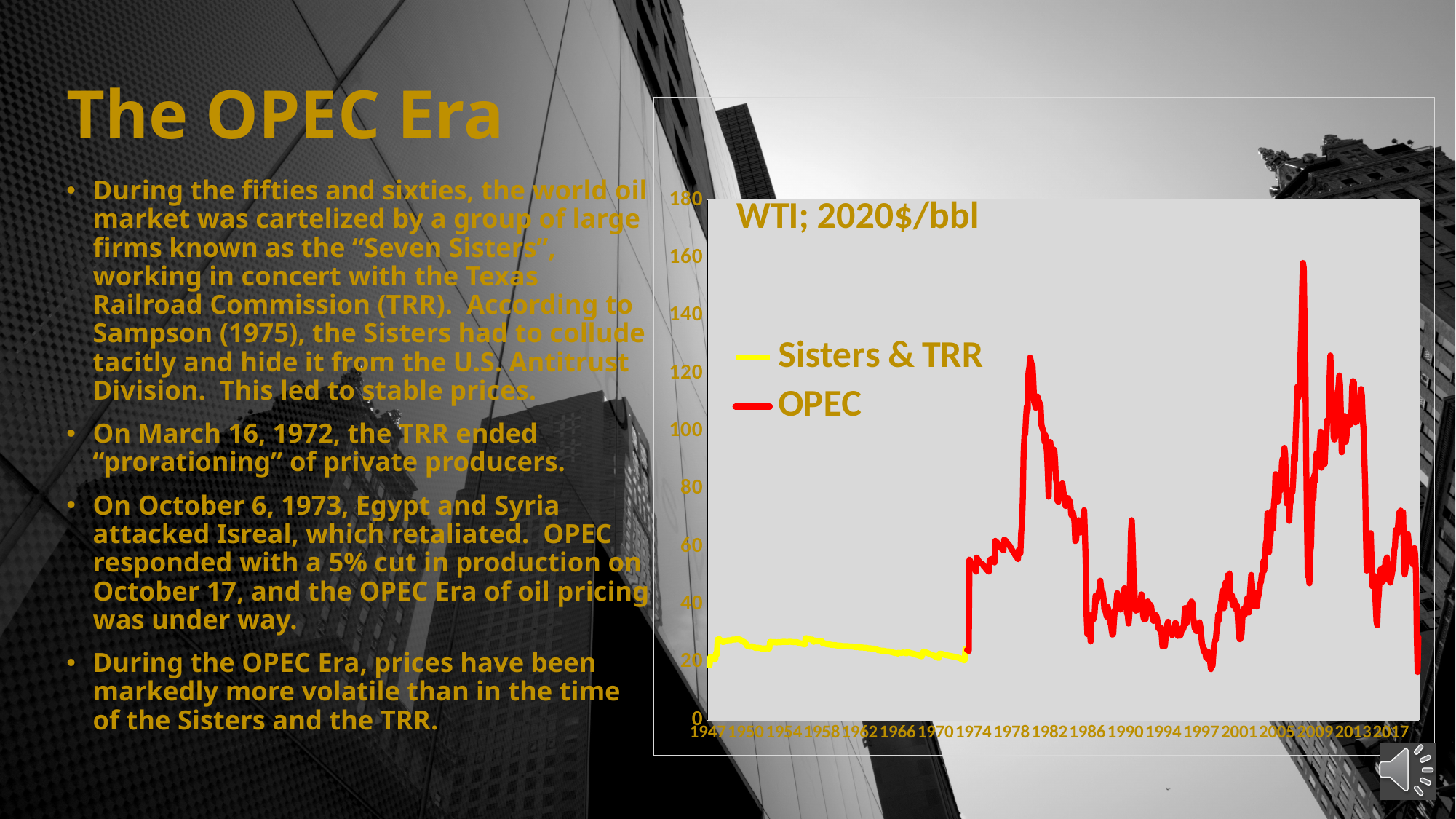
Is the highest value of the OPEC series (around 2008) greater or less than 140? greater Is the value of the Sisters & TRR series in 1958 greater or less than 40? less Which series is drawn in red on the chart? OPEC What kind of chart is shown on the slide? line chart What is the highest value shown on the chart's vertical axis? 180 Does the OPEC series rise or fall between 2002 and 2008? rise Which series reaches the higher peak value, Sisters & TRR or OPEC? OPEC Does the OPEC series rise or fall between 1981 and 1986? fall What is the title of the chart? WTI; 2020$/bbl How many series does the chart's legend list? 2 Is the value of the OPEC series around 1980 greater or less than 100? greater